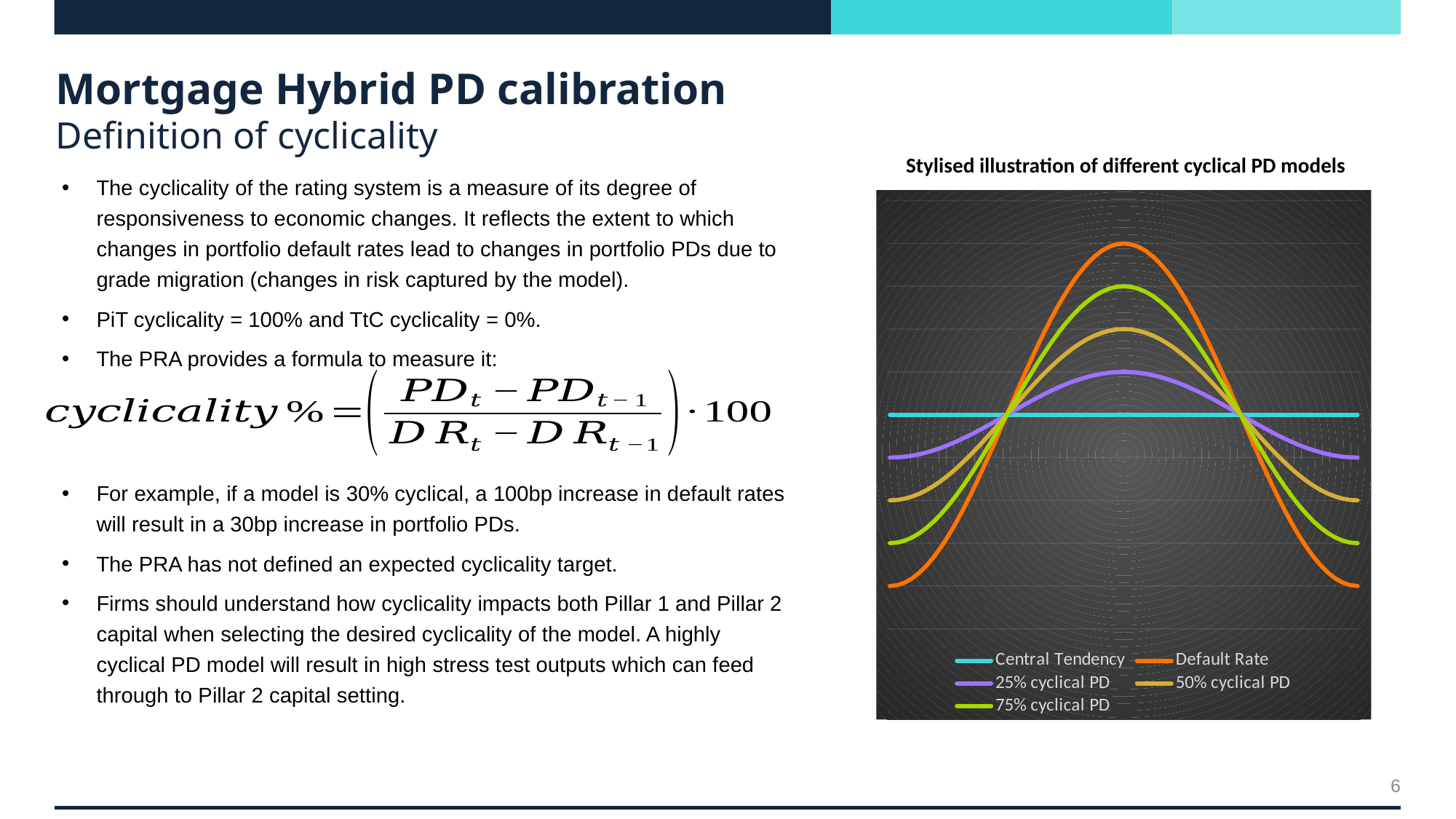
What kind of chart is shown on the slide? Line chart What colour is the Default Rate line in the chart? Orange Which series has the higher peak, 75% cyclical PD or 50% cyclical PD? 75% cyclical PD How many series does the chart's legend list? 5 Which series in the chart is a flat horizontal line with no cyclical variation? Central Tendency Which series has the smallest amplitude among the cyclical PD lines (25%, 50%, 75%)? 25% cyclical PD Which series in the chart reaches the highest peak? Default Rate What is the title of the chart? Stylised illustration of different cyclical PD models Which series has the lower peak, 25% cyclical PD or Default Rate? 25% cyclical PD